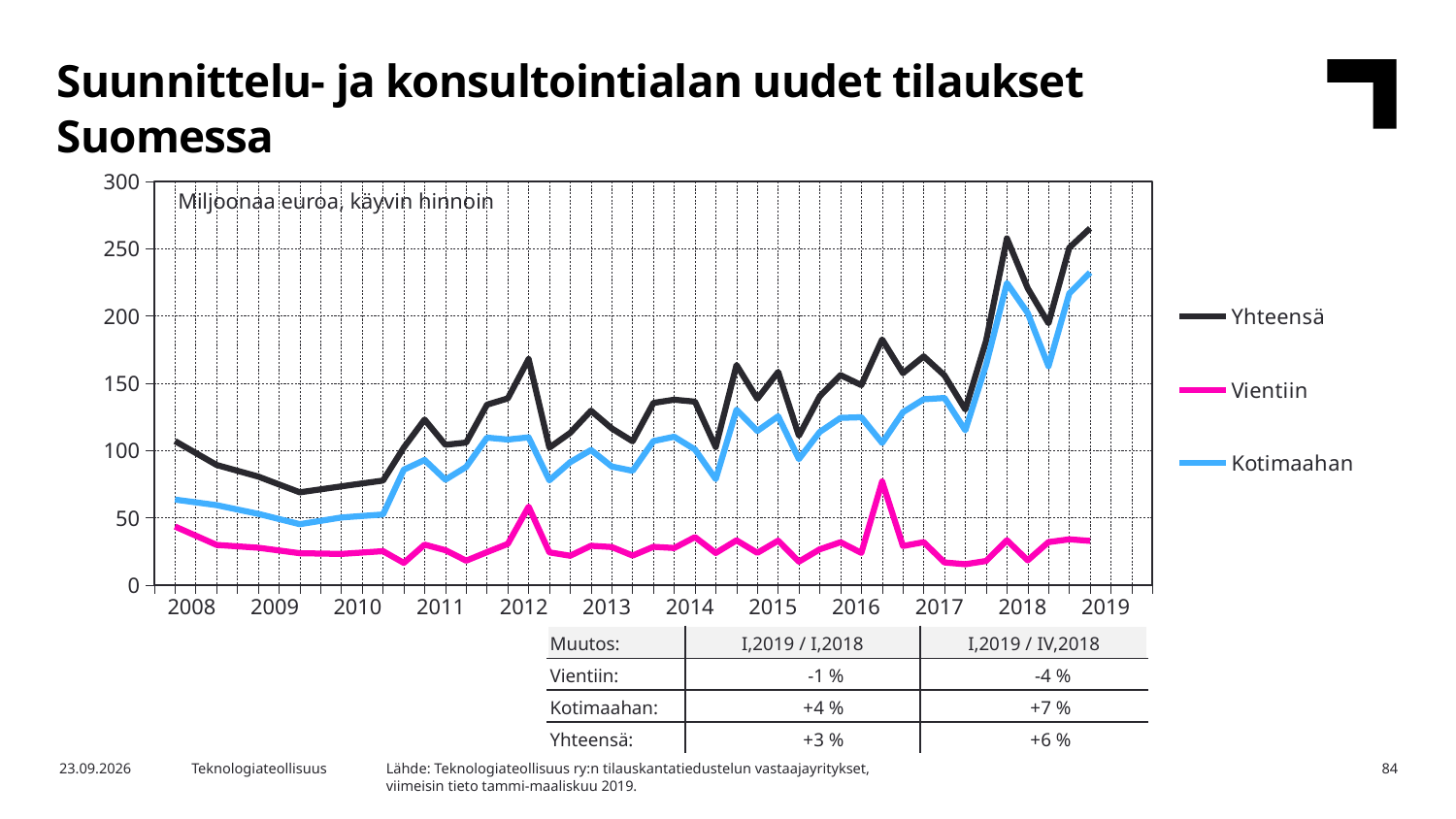
Which series has the highest values throughout the chart? Yhteensä How many years are labelled on the x axis of the chart? 12 Does the Yhteensä series rise or fall overall from 2017 to 2019? rise At the last point in 2019, which is larger: Kotimaahan or Vientiin? Kotimaahan Which series has the lowest values throughout the chart? Vientiin Is the value for Kotimaahan at the last point in 2019 greater or less than 200? greater What kind of chart is shown on the slide? line chart Is the value for Yhteensä at the last point in 2019 greater or less than 250? greater What are the three series named in the chart legend? Yhteensä, Vientiin, Kotimaahan What unit is stated in the text box inside the chart area? Miljoonaa euroa, käyvin hinnoin How many series does the chart legend list? 3 Is the value for Vientiin at the last point in 2019 greater or less than 50? less